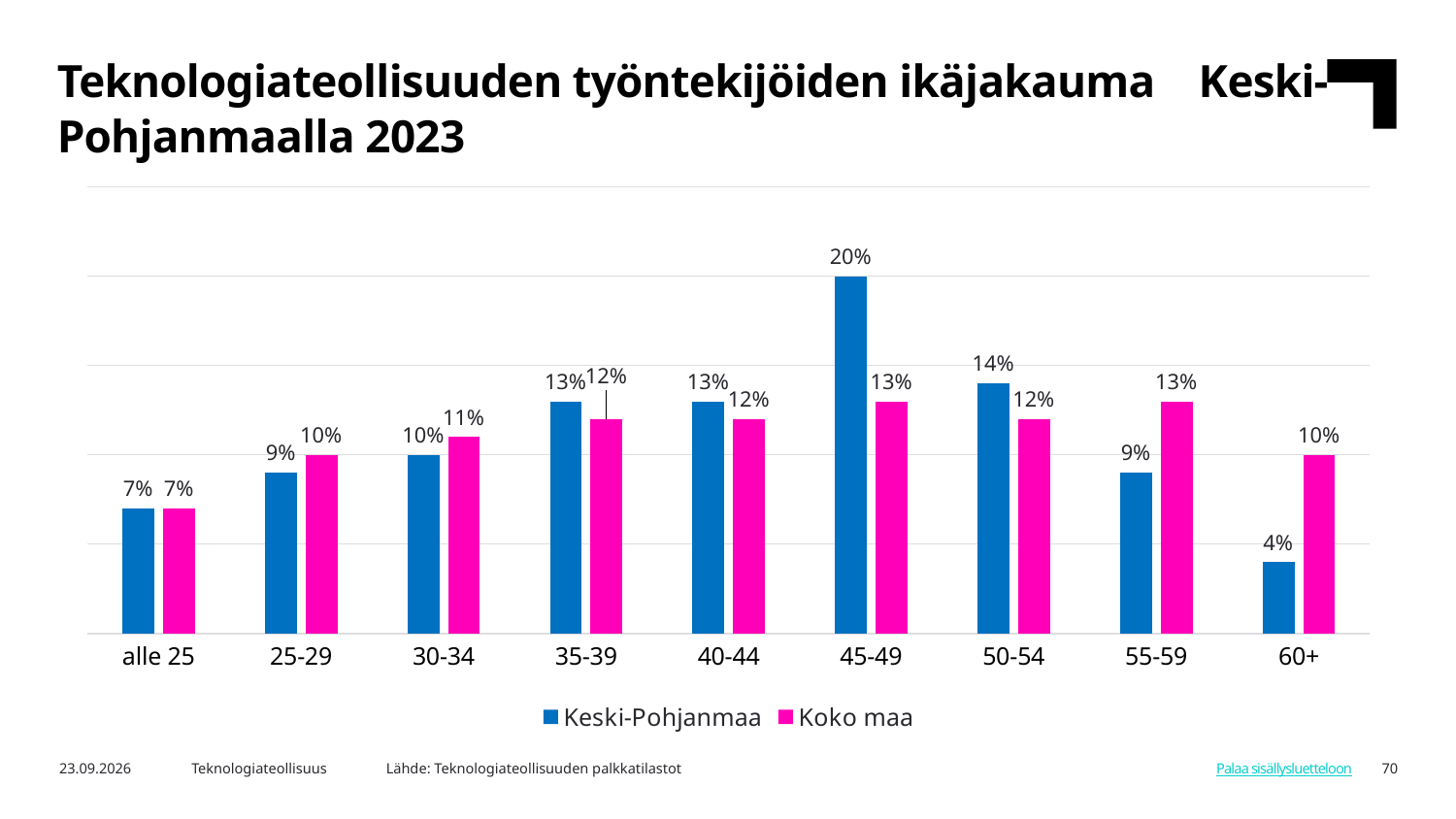
In the 55-59 age group, which series has the larger value, Keski-Pohjanmaa or Koko maa? Koko maa How many age groups are shown on the x axis? 9 How many series does the legend list? 2 What is the value for Koko maa in the 60+ age group? 10% What is the value for Keski-Pohjanmaa in the 45-49 age group? 20% Which age group has the lowest value for Keski-Pohjanmaa? 60+ What is the value for Koko maa in the 30-34 age group? 11% What is the value for Keski-Pohjanmaa in the 60+ age group? 4% Which series is shown in pink in the legend? Koko maa Which age group has the highest value for Keski-Pohjanmaa? 45-49 What is the difference between Keski-Pohjanmaa and Koko maa in the 45-49 age group? 7 percentage points What kind of chart is shown on the slide? Bar chart